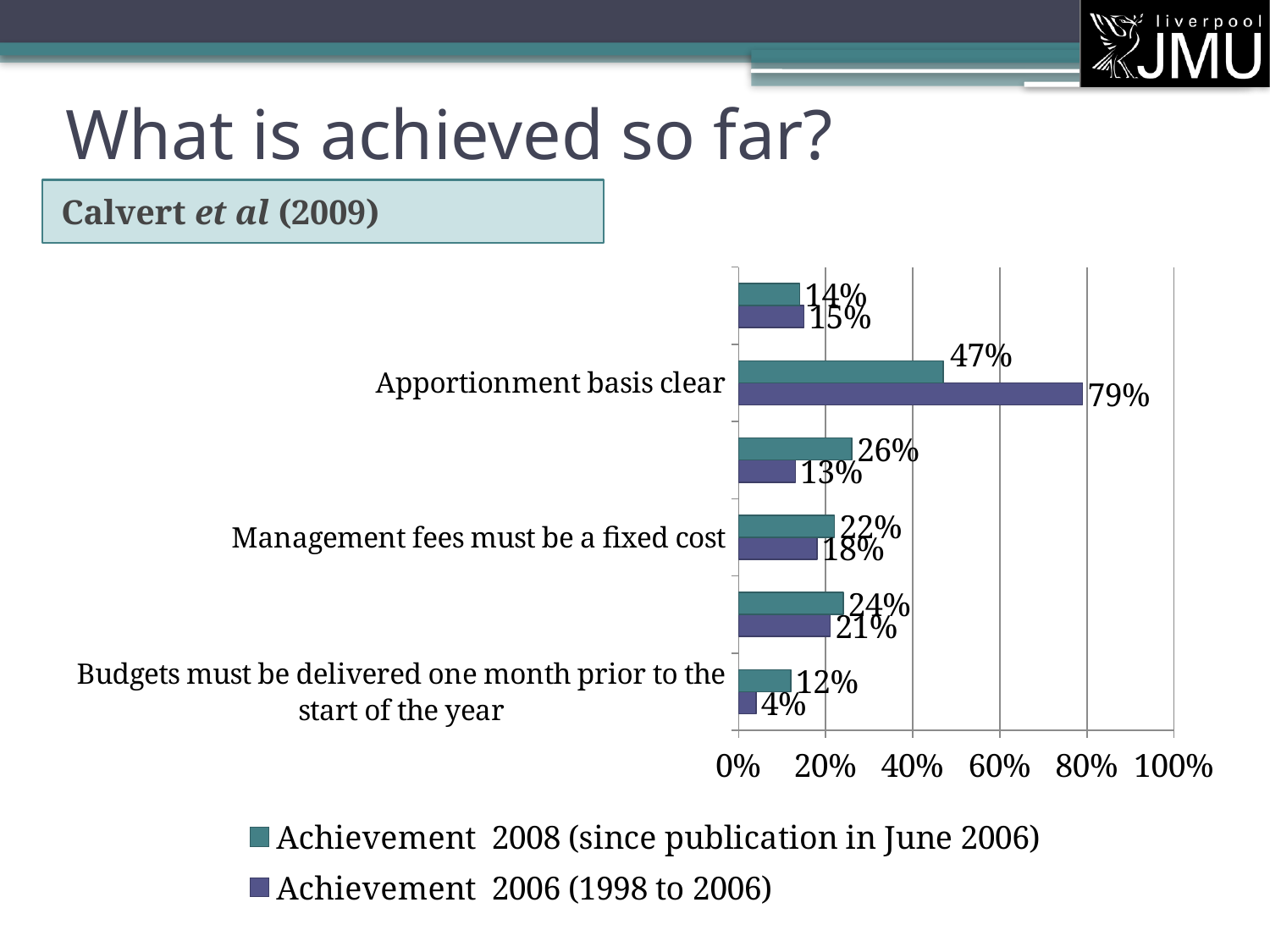
Which series is shown in purple in the legend? Achievement 2006 (1998 to 2006) How many series does the legend list? 2 What is the difference between the Achievement 2006 and Achievement 2008 values for Apportionment basis clear? 32% For Management fees must be a fixed cost, which is larger: the Achievement 2008 value or the Achievement 2006 value? Achievement 2008 What kind of chart is shown on the slide? Bar chart Which labelled category has the highest Achievement 2006 value? Apportionment basis clear What is the Achievement 2008 (since publication in June 2006) value for Apportionment basis clear? 47% What is the Achievement 2008 value for Management fees must be a fixed cost? 22% What is the Achievement 2008 value for Budgets must be delivered one month prior to the start of the year? 12% Which labelled category has the lowest Achievement 2006 value? Budgets must be delivered one month prior to the start of the year What is the Achievement 2006 value for Budgets must be delivered one month prior to the start of the year? 4% What is the Achievement 2006 (1998 to 2006) value for Apportionment basis clear? 79%